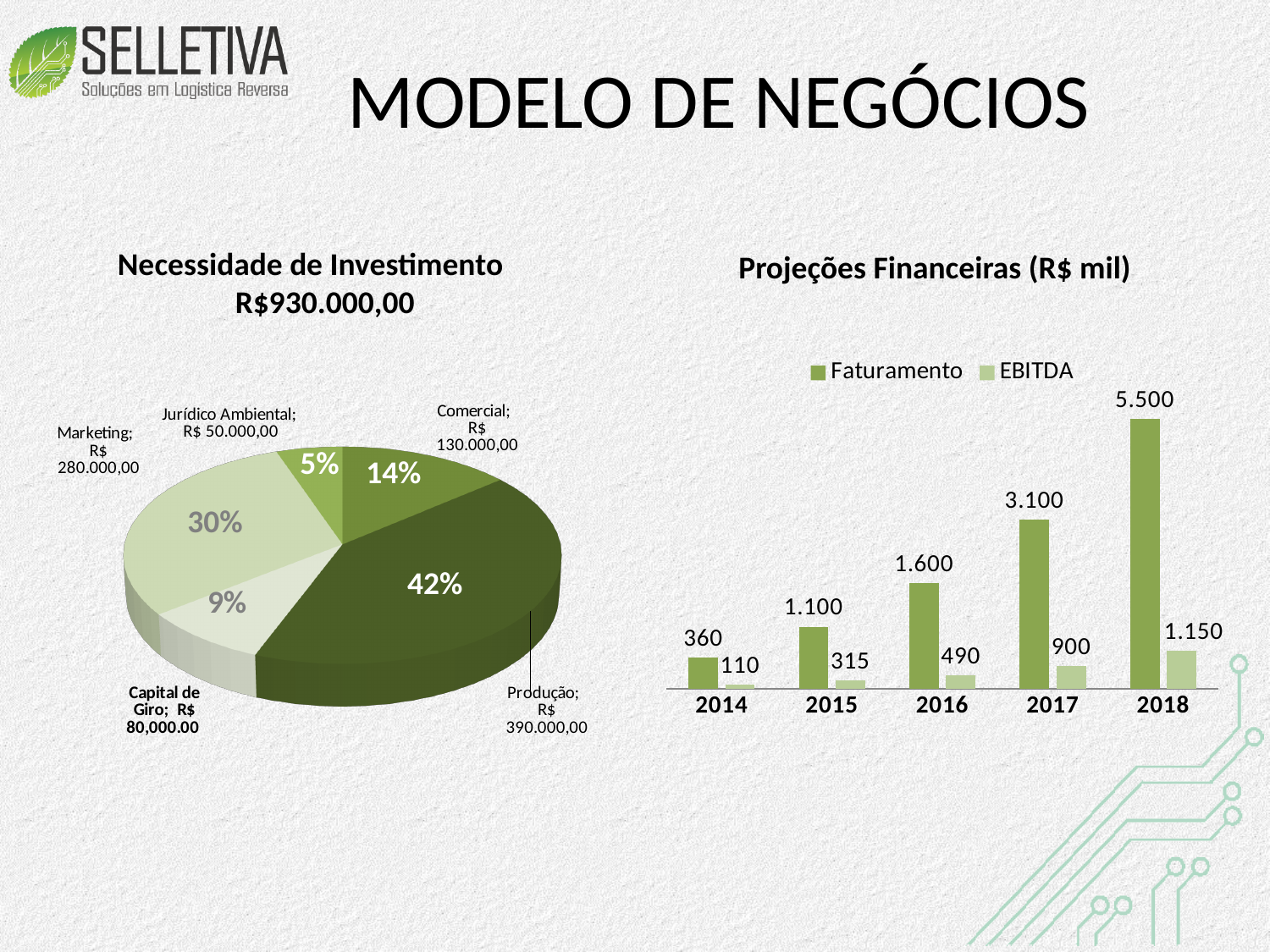
In the 'Projeções Financeiras (R$ mil)' chart, what is the Faturamento value for 2017? 3.100 In the 'Necessidade de Investimento' pie chart, what is the value for Marketing? R$ 280.000,00 In the 'Necessidade de Investimento' pie chart, what share does Produção represent? 42% In the 'Projeções Financeiras (R$ mil)' chart, how many series does the legend list? 2 In the 'Projeções Financeiras (R$ mil)' chart, which year has the lowest EBITDA? 2014 In the 'Projeções Financeiras (R$ mil)' chart, what is the EBITDA value for 2016? 490 In the 'Necessidade de Investimento' pie chart, which category has the smallest slice? Jurídico Ambiental How many slices does the 'Necessidade de Investimento' pie chart have? 5 What kind of chart is 'Projeções Financeiras (R$ mil)'? bar chart In the 'Projeções Financeiras (R$ mil)' chart, does Faturamento rise or fall from 2014 to 2018? rise In the 'Projeções Financeiras (R$ mil)' chart, which year has the highest Faturamento? 2018 In the 'Projeções Financeiras (R$ mil)' chart, what is the difference between Faturamento in 2018 and Faturamento in 2017? 2.400